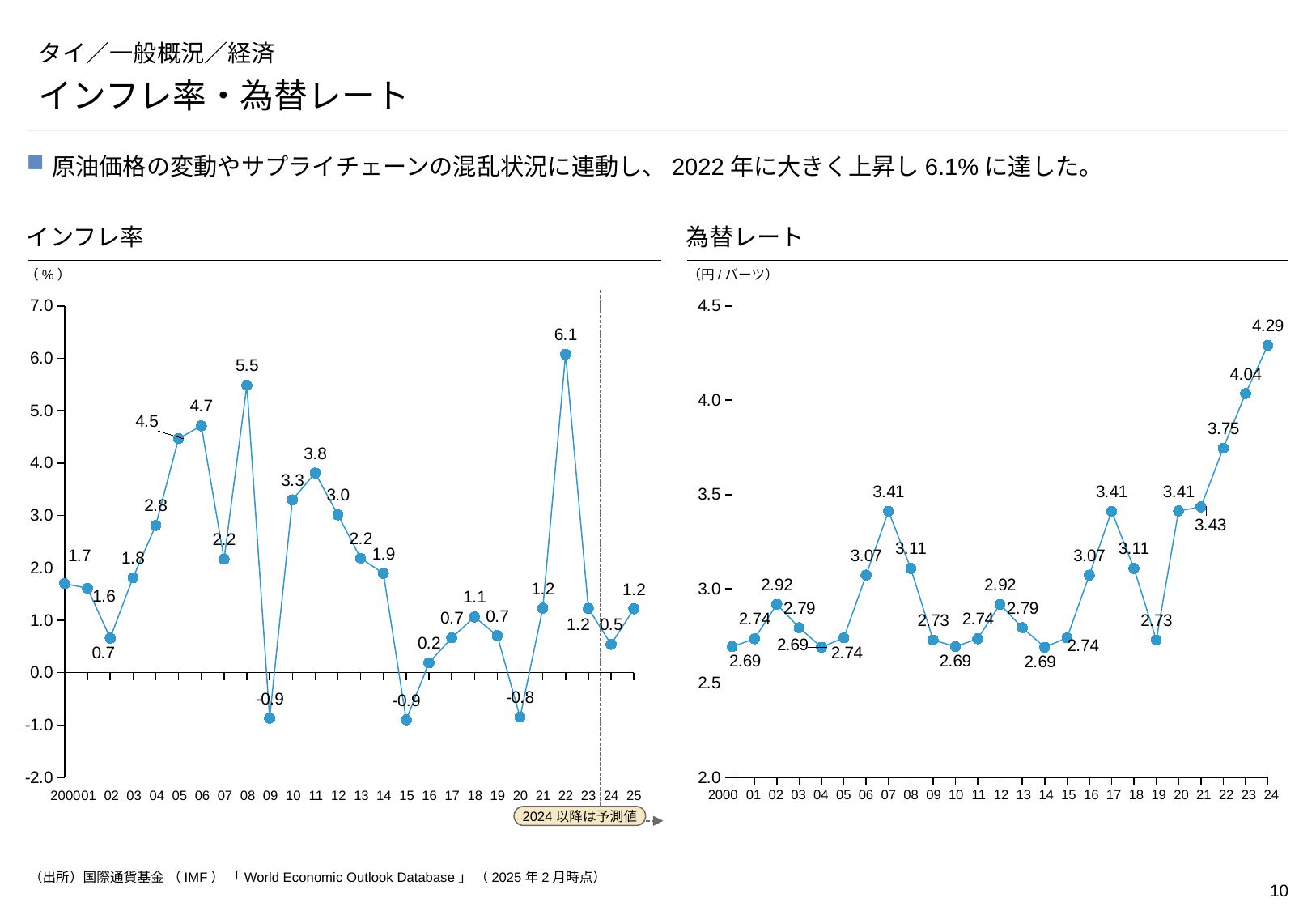
In the 為替レート chart, do the values rise or fall from 2020 to 2024? rise In the 為替レート chart, what is the value for 2024? 4.29 In the インフレ率 chart, what is the difference between the 2022 value and the 2023 value? 4.9 In the インフレ率 chart, what is the inflation rate for 2022? 6.1 In the 為替レート chart, what is the difference between the 2024 value and the 2023 value? 0.25 In the 為替レート chart, what is the value for 2019? 2.73 In the インフレ率 chart, which is larger, the value for 2005 or the value for 2006? 2006 What type of chart is the 為替レート chart? line chart In the インフレ率 chart, what is the value for 2020? -0.8 In the 為替レート chart, which year has the highest value? 2024 In the インフレ率 chart, which year has the highest inflation rate? 2022 In the インフレ率 chart, what is the value for 2008? 5.5